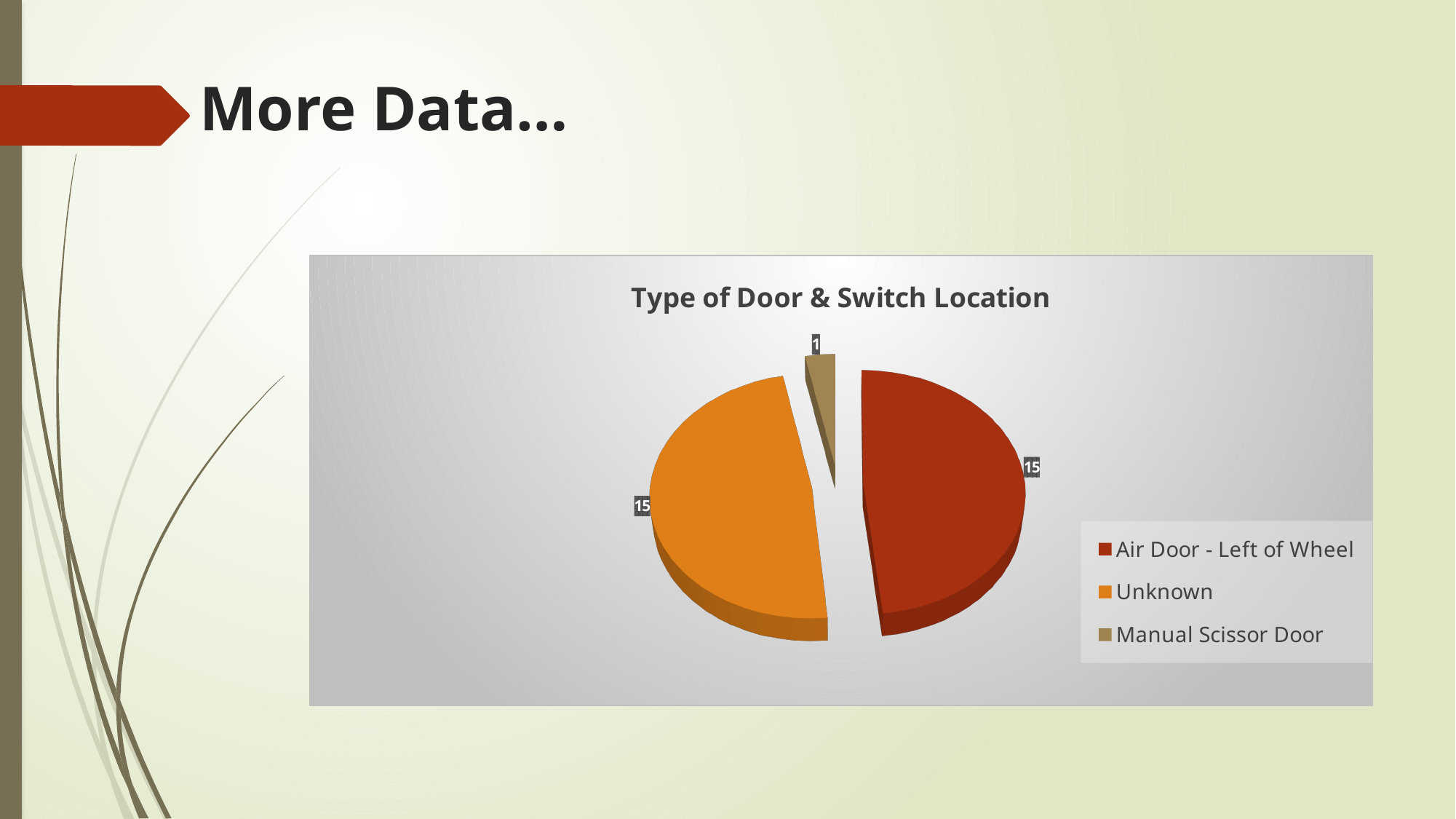
How many entries does the legend list? 3 What is the value for Unknown? 15 Which category has the smallest slice of the pie? Manual Scissor Door What is the value for Air Door - Left of Wheel? 15 Which is larger, the value for Unknown or the value for Manual Scissor Door? Unknown What is the difference between the value for Air Door - Left of Wheel and the value for Manual Scissor Door? 14 Which colour represents Unknown in the pie chart? Orange What is the value for Manual Scissor Door? 1 What is the title of the chart? Type of Door & Switch Location What type of chart is shown on the slide? Pie chart How many categories are shown in the pie chart? 3 What is the total of all the slices in the pie chart? 31